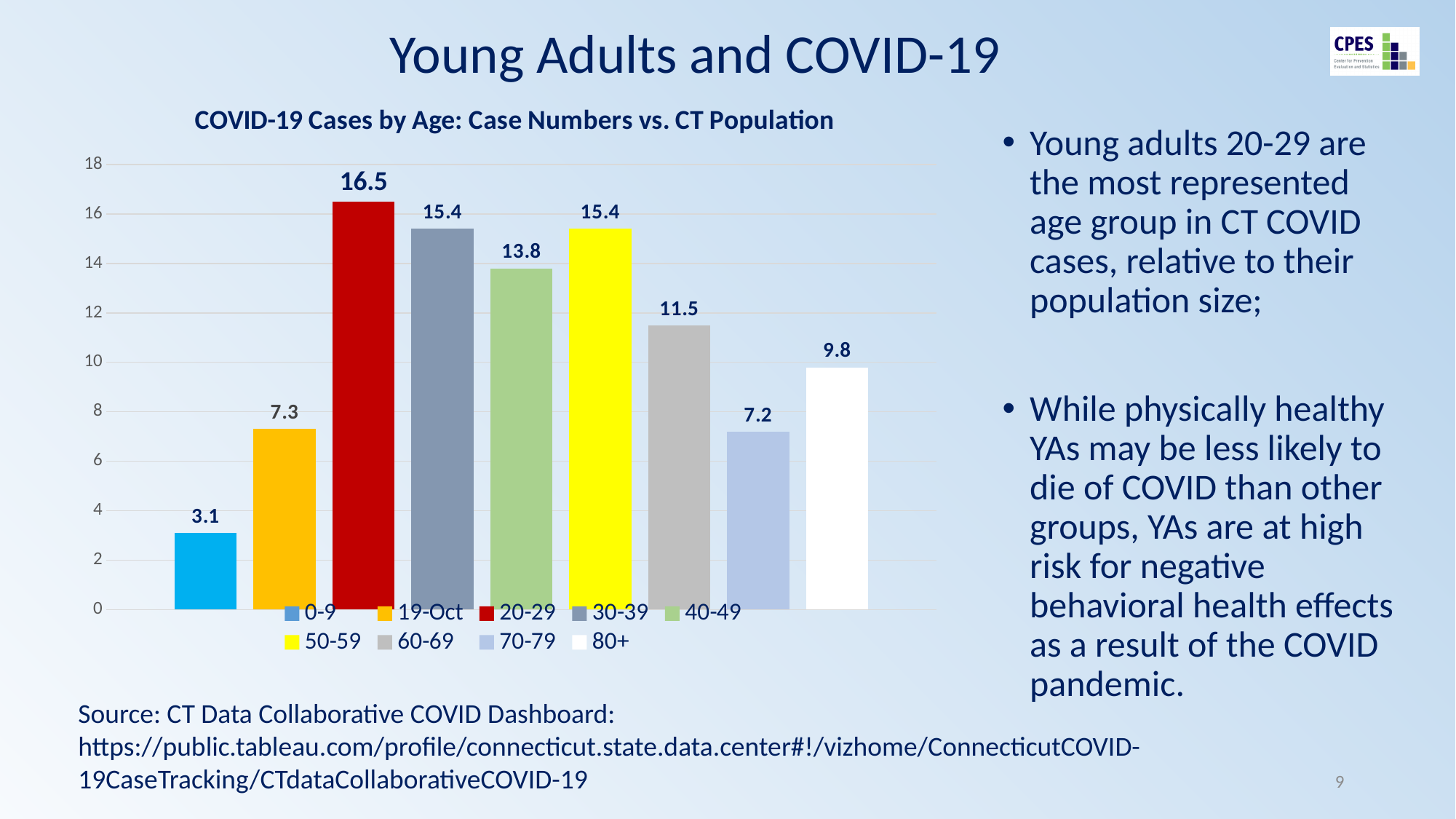
Which age group has the highest value in the chart? 20-29 What is the value for the 0-9 age group? 3.1 Which age group has the lowest value in the chart? 0-9 What is the value for the 60-69 age group? 11.5 What is the title of the chart on the slide? COVID-19 Cases by Age: Case Numbers vs. CT Population How many age groups are plotted in the chart? 9 What is the difference between the values for the 80+ and 70-79 age groups? 2.6 What kind of chart is shown on the slide? Bar chart What is the difference between the values for the 20-29 and 30-39 age groups? 1.1 What is the value for the 20-29 age group in the COVID-19 Cases by Age chart? 16.5 Which is larger, the value for 40-49 or the value for 60-69? 40-49 What is the value for the 80+ age group? 9.8